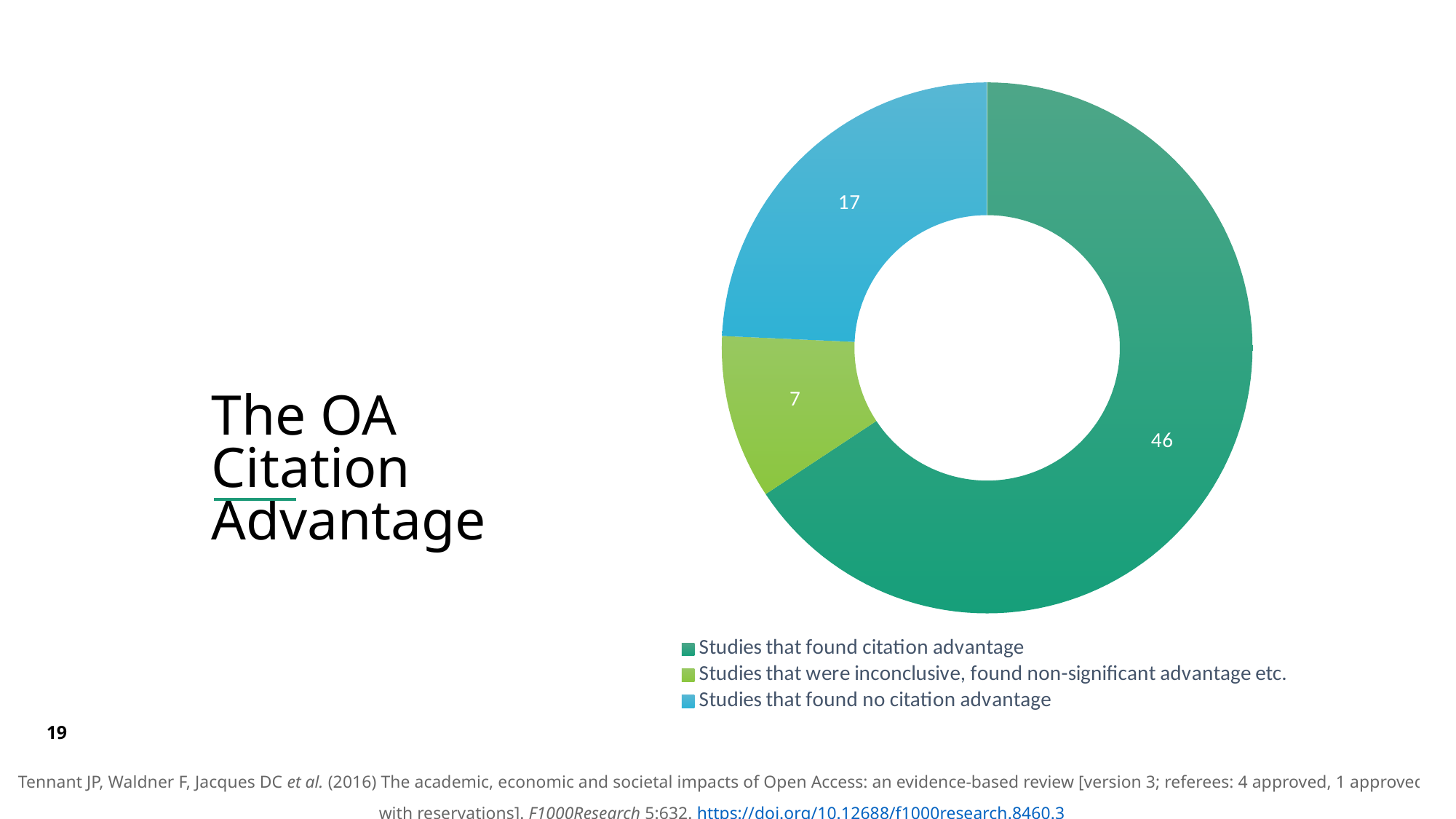
Which category has the smallest slice of the chart? Studies that were inconclusive, found non-significant advantage etc. What is the total number of studies across all three slices? 70 What kind of chart is shown on the slide? Doughnut (pie) chart What is the difference between the number of studies that found a citation advantage and the number that found no citation advantage? 29 What value is shown for studies that were inconclusive or found a non-significant advantage? 7 What value is shown for studies that found no citation advantage? 17 Which category has the largest slice of the chart? Studies that found citation advantage How many categories does the chart show? 3 Which is larger: the number of studies that found no citation advantage or the number of inconclusive studies? Studies that found no citation advantage How many studies found a citation advantage according to the chart? 46 What share of the total do the studies that were inconclusive represent? 10% What colour is the slice for studies that found no citation advantage? Blue